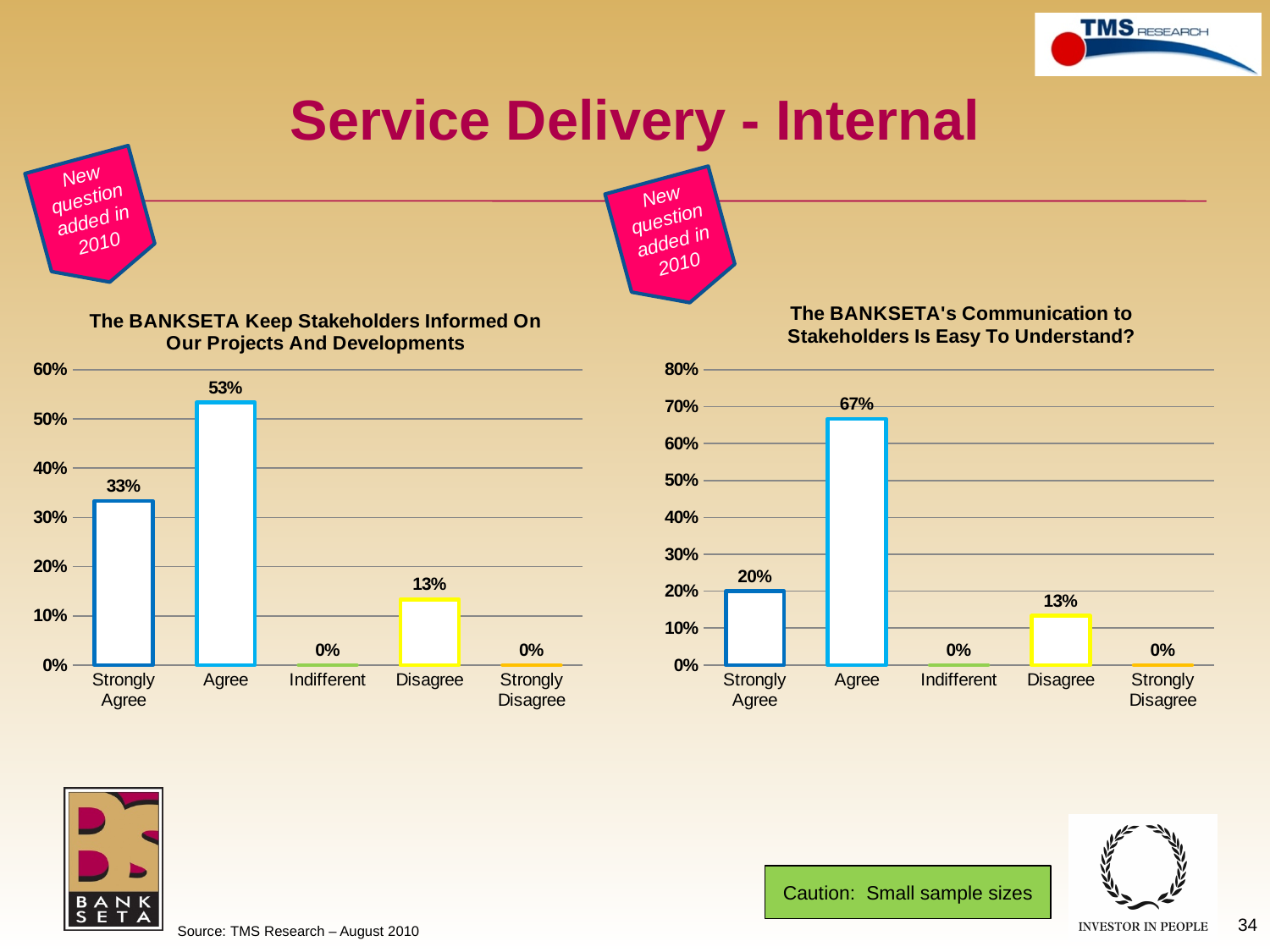
In the right chart, what is the difference between the values for Agree and Strongly Agree? 47% In the chart titled "The BANKSETA Keep Stakeholders Informed On Our Projects And Developments", what is the value for Agree? 53% In the chart titled "The BANKSETA's Communication to Stakeholders Is Easy To Understand?", what is the value for Disagree? 13% In the chart titled "The BANKSETA Keep Stakeholders Informed On Our Projects And Developments", what is the value for Strongly Agree? 33% What kind of chart is the chart titled "The BANKSETA's Communication to Stakeholders Is Easy To Understand?"? Bar chart In the right chart, which is larger: the value for Strongly Agree or the value for Disagree? Strongly Agree In the left chart, is the value for Strongly Agree greater or less than 30%? greater In the left chart, which category has the highest value? Agree In the left chart, what is the difference between the values for Agree and Strongly Agree? 20% In the chart titled "The BANKSETA's Communication to Stakeholders Is Easy To Understand?", what is the value for Agree? 67% How many categories are shown on the x axis of the left chart? 5 In the right chart, which category has the highest value? Agree